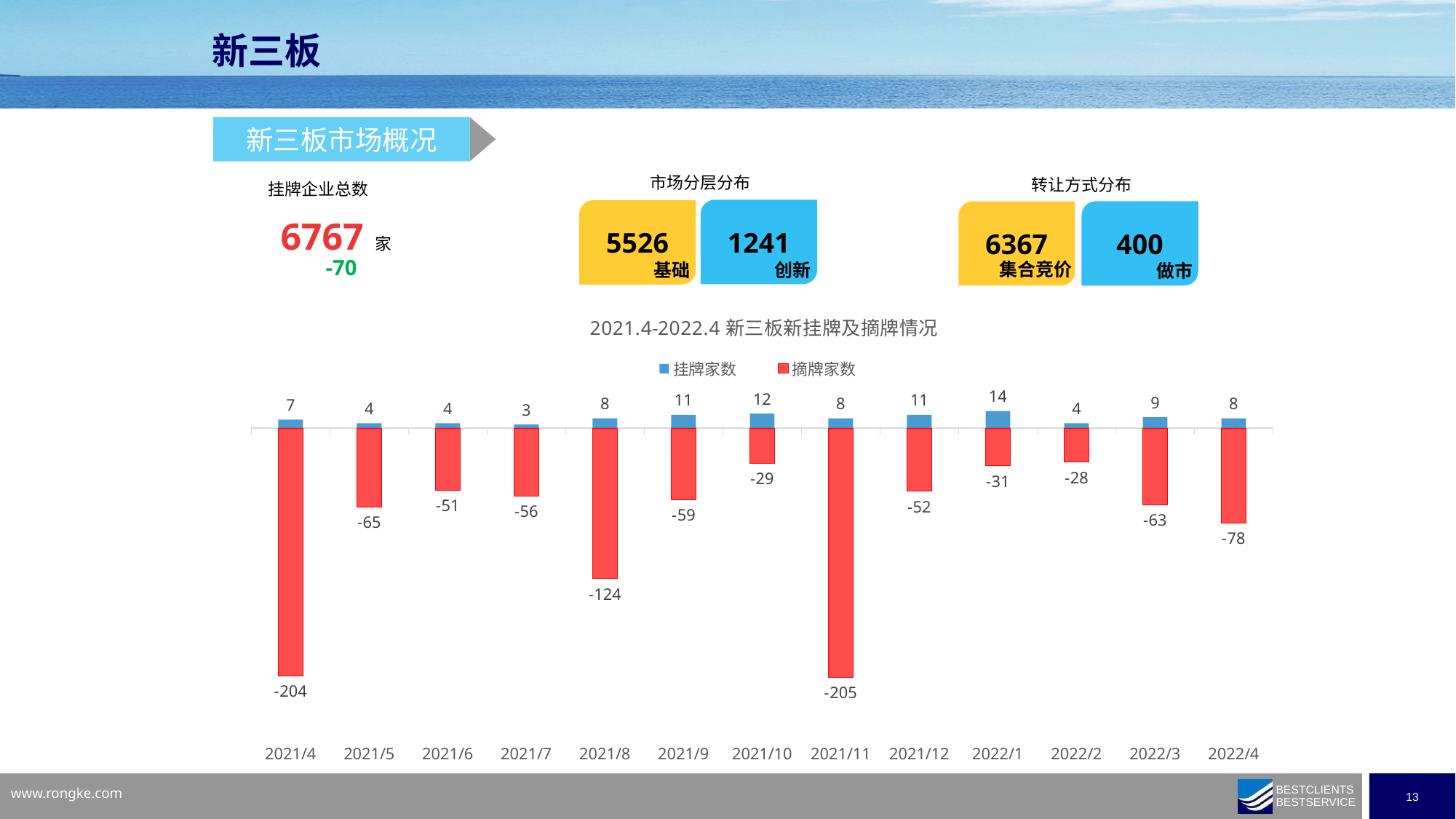
What is the difference between the 挂牌家数 for 2021/10 and 2021/5? 8 Which month has the highest 挂牌家数? 2022/1 Which is larger in absolute value, the 摘牌家数 for 2021/4 or for 2021/11? 2021/11 What is the 摘牌家数 value for 2021/8? -124 Which month has the lowest 挂牌家数? 2021/7 How many series does the chart legend list? 2 How many months are shown on the x axis of the chart? 13 What is the title of the chart? 2021.4-2022.4 新三板新挂牌及摘牌情况 What type of chart is shown on the slide? bar chart What is the 挂牌家数 value for 2022/1? 14 Which month has the smallest 摘牌家数 in absolute terms (the shortest red bar)? 2022/2 What is the 摘牌家数 value for 2021/11? -205